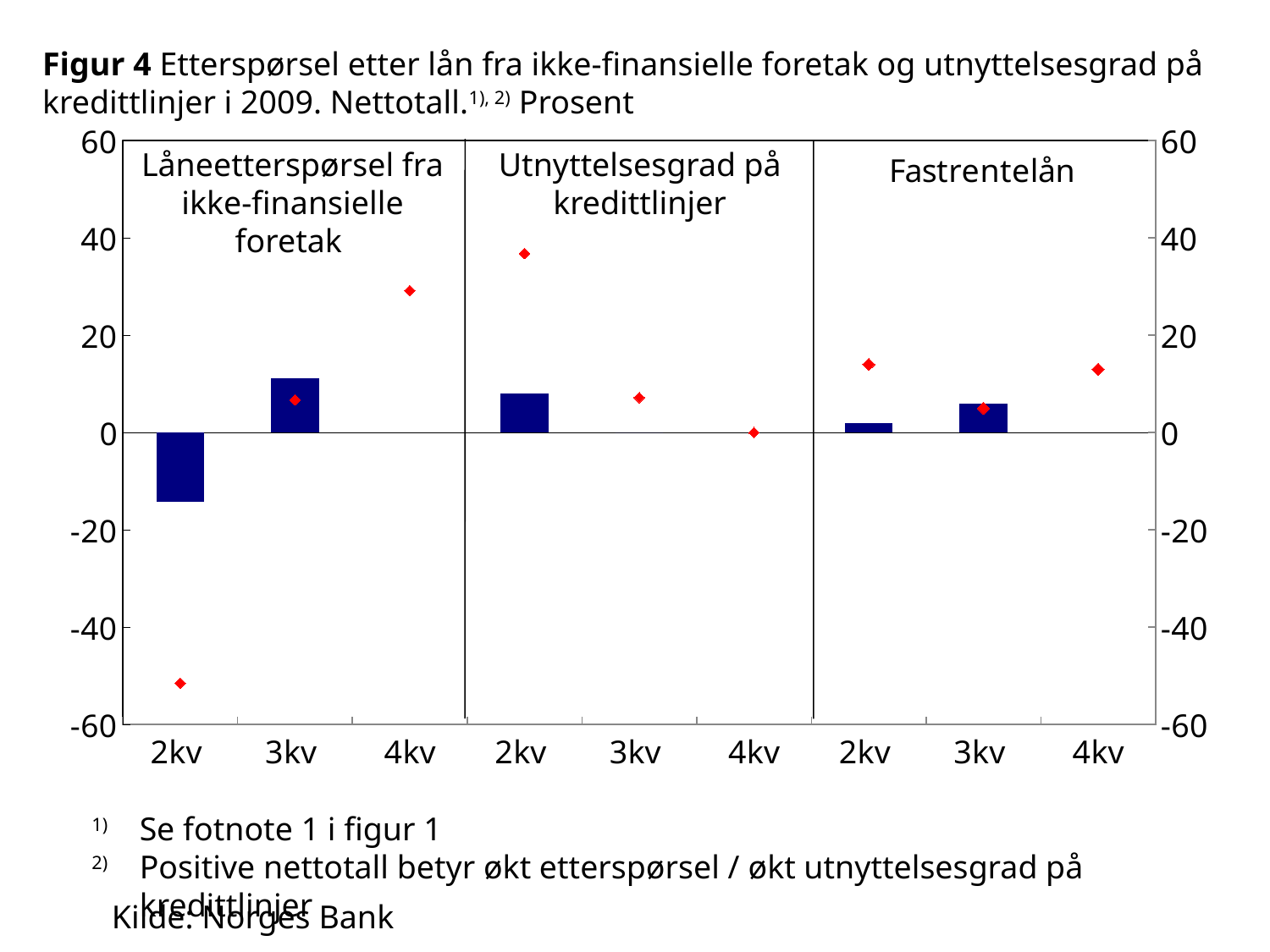
How many panels (sections) does the chart have? 3 In the panel 'Utnyttelsesgrad på kredittlinjer', do the red markers rise or fall from 2kv to 4kv? fall What is the title of the middle panel of the chart? Utnyttelsesgrad på kredittlinjer In the panel 'Låneetterspørsel fra ikke-finansielle foretak', is the red marker for 2kv greater or less than -40? less In the panel 'Låneetterspørsel fra ikke-finansielle foretak', which quarter has the lowest red marker? 2kv In the panel 'Låneetterspørsel fra ikke-finansielle foretak', is the red marker for 4kv greater or less than 20? greater What colour are the bars in the chart? dark blue In the panel 'Utnyttelsesgrad på kredittlinjer', which is larger, the red marker for 2kv or for 3kv? 2kv In the panel 'Utnyttelsesgrad på kredittlinjer', is the red marker for 2kv greater or less than 20? greater How many quarters are shown on the x axis within each panel? 3 What kind of chart is shown on the slide? combination chart with bars and markers (bar and line chart)